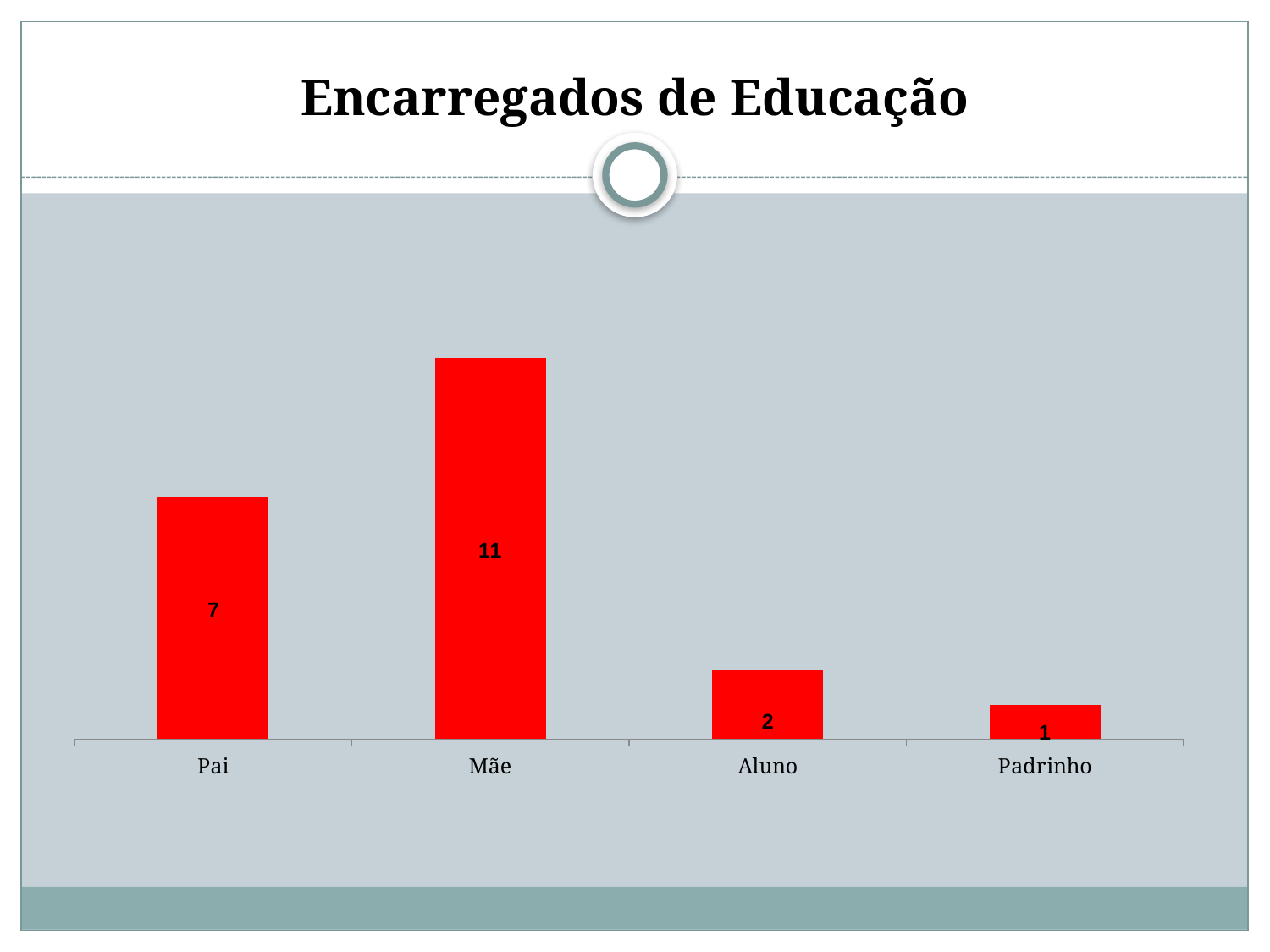
How many categories are shown on the x axis? 4 What is the difference between the values for Mãe and Pai? 4 Which category has the highest value? Mãe Which category has the lowest value? Padrinho What kind of chart is shown on the slide? Bar chart What is the difference between the values for Aluno and Padrinho? 1 Which is larger, the value for Pai or the value for Aluno? Pai What is the title of the slide containing the chart? Encarregados de Educação What is the value for Padrinho? 1 What is the value for Aluno? 2 What is the value for Pai? 7 What is the value for Mãe? 11